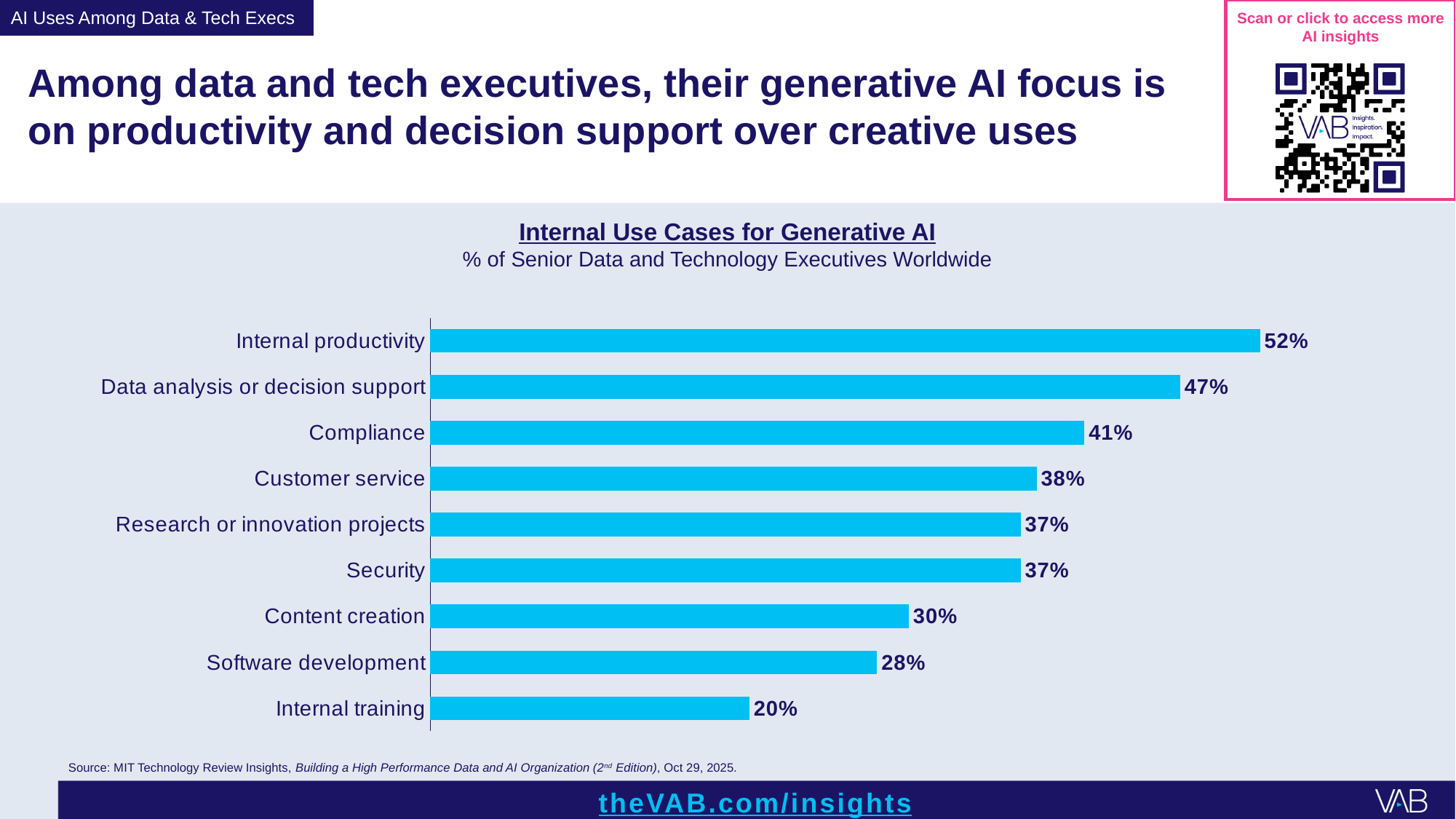
How many internal use cases are shown in the chart? 9 What is the difference in percentage points between Compliance and Internal training? 21 Which internal use case has the lowest percentage? Internal training Which internal use case has the highest percentage? Internal productivity Which has a higher value, Customer service or Content creation? Customer service What is the title of the chart? Internal Use Cases for Generative AI What type of chart is used on this slide? Bar chart What is the value shown for Content creation? 30% What percentage is shown for Software development? 28% What is the difference in percentage points between Internal productivity and Data analysis or decision support? 5 What percentage of senior data and technology executives cite internal productivity as an internal use case for generative AI? 52% Which has a higher value, Compliance or Software development? Compliance